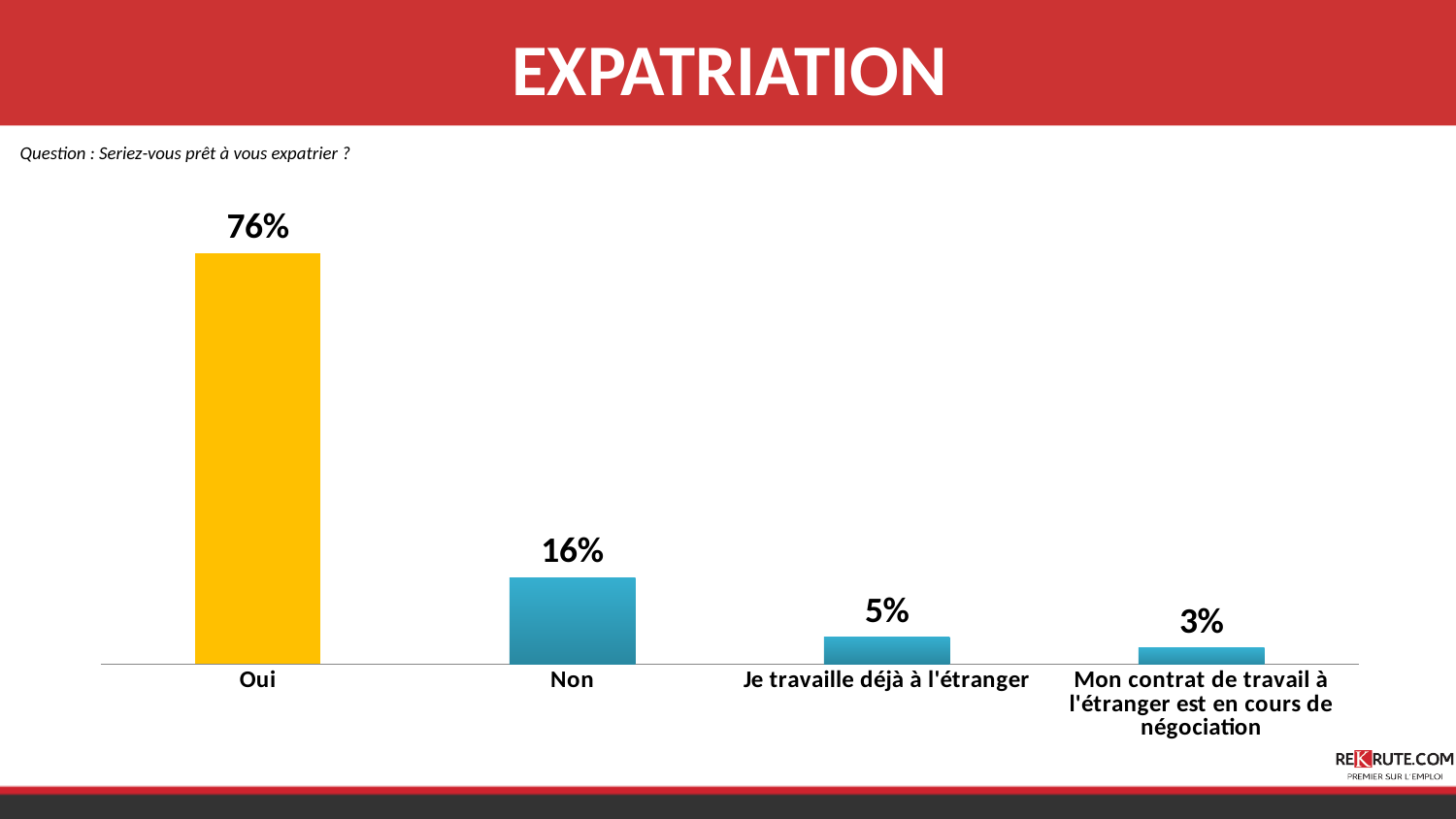
Which bar is coloured differently (yellow) from the others? Oui Which response category has the lowest value? Mon contrat de travail à l'étranger est en cours de négociation What is the difference between "Je travaille déjà à l'étranger" and "Mon contrat de travail à l'étranger est en cours de négociation"? 2 percentage points What percentage of respondents answered "Non"? 16% What type of chart is shown on the slide? Bar chart What is the difference between the "Oui" and "Non" values? 60 percentage points What is the value for "Mon contrat de travail à l'étranger est en cours de négociation"? 3% How many response categories are shown in the chart? 4 Which is larger, the value for "Non" or the value for "Je travaille déjà à l'étranger"? Non What is the value for "Je travaille déjà à l'étranger"? 5% Which response category has the highest value? Oui What percentage of respondents answered "Oui"? 76%